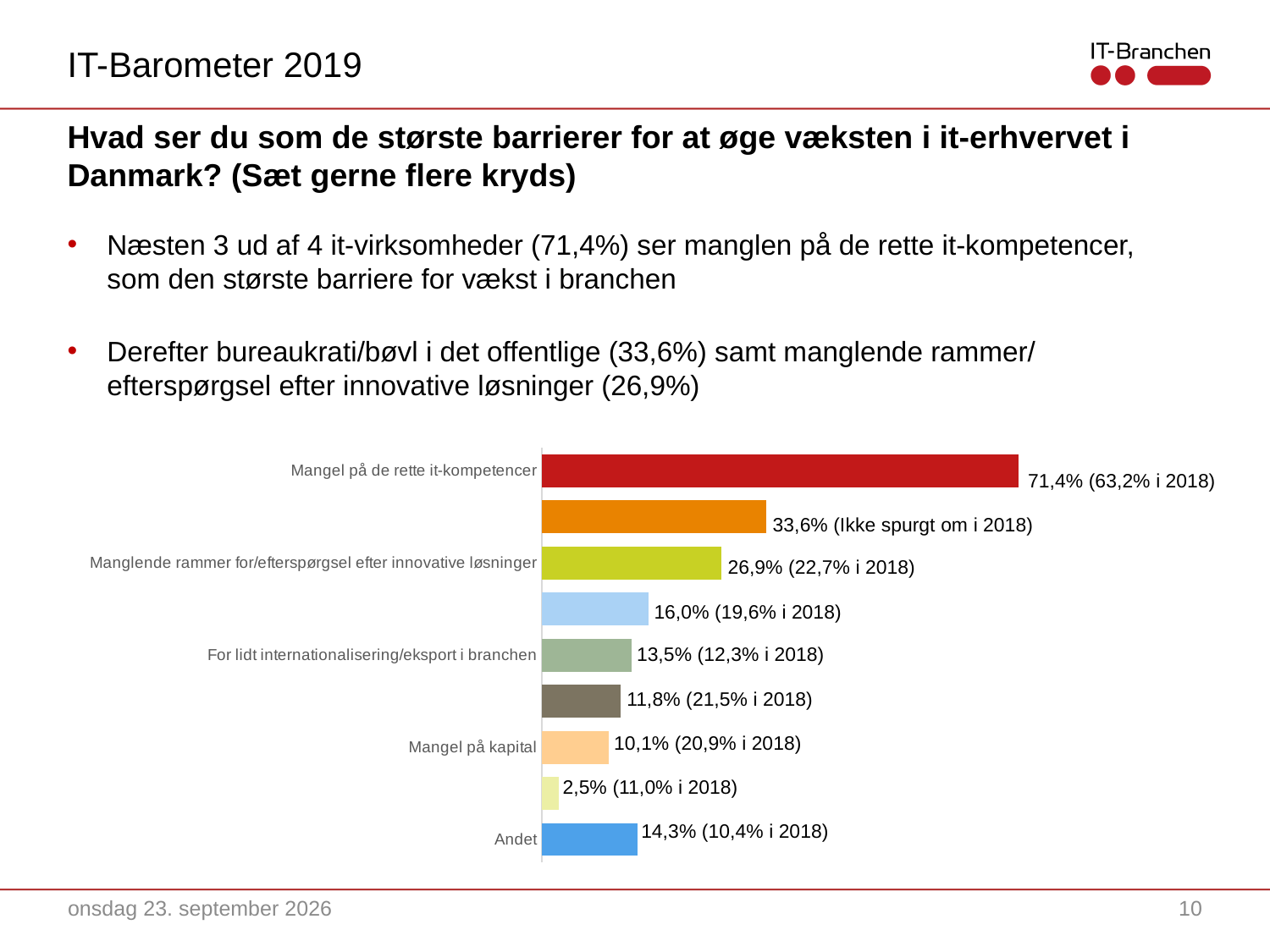
What is the difference between the 2019 values for 'Mangel på de rette it-kompetencer' and 'Manglende rammer for/efterspørgsel efter innovative løsninger'? 44,5 percentage points What is the 2019 value for 'For lidt internationalisering/eksport i branchen'? 13,5% What is the lowest 2019 value shown in the chart? 2,5% What kind of chart is shown on the slide? bar chart What is the 2019 value for 'Manglende rammer for/efterspørgsel efter innovative løsninger'? 26,9% Which category has the highest value in the chart? Mangel på de rette it-kompetencer How many bars does the chart contain? 9 What is the 2019 value for 'Mangel på kapital'? 10,1% What is the 2019 value for 'Andet'? 14,3% What is the 2019 value for 'Mangel på de rette it-kompetencer'? 71,4% Which has the larger 2019 value, 'Andet' or 'Mangel på kapital'? Andet What was the 2018 value for 'Mangel på de rette it-kompetencer' according to the data label? 63,2%